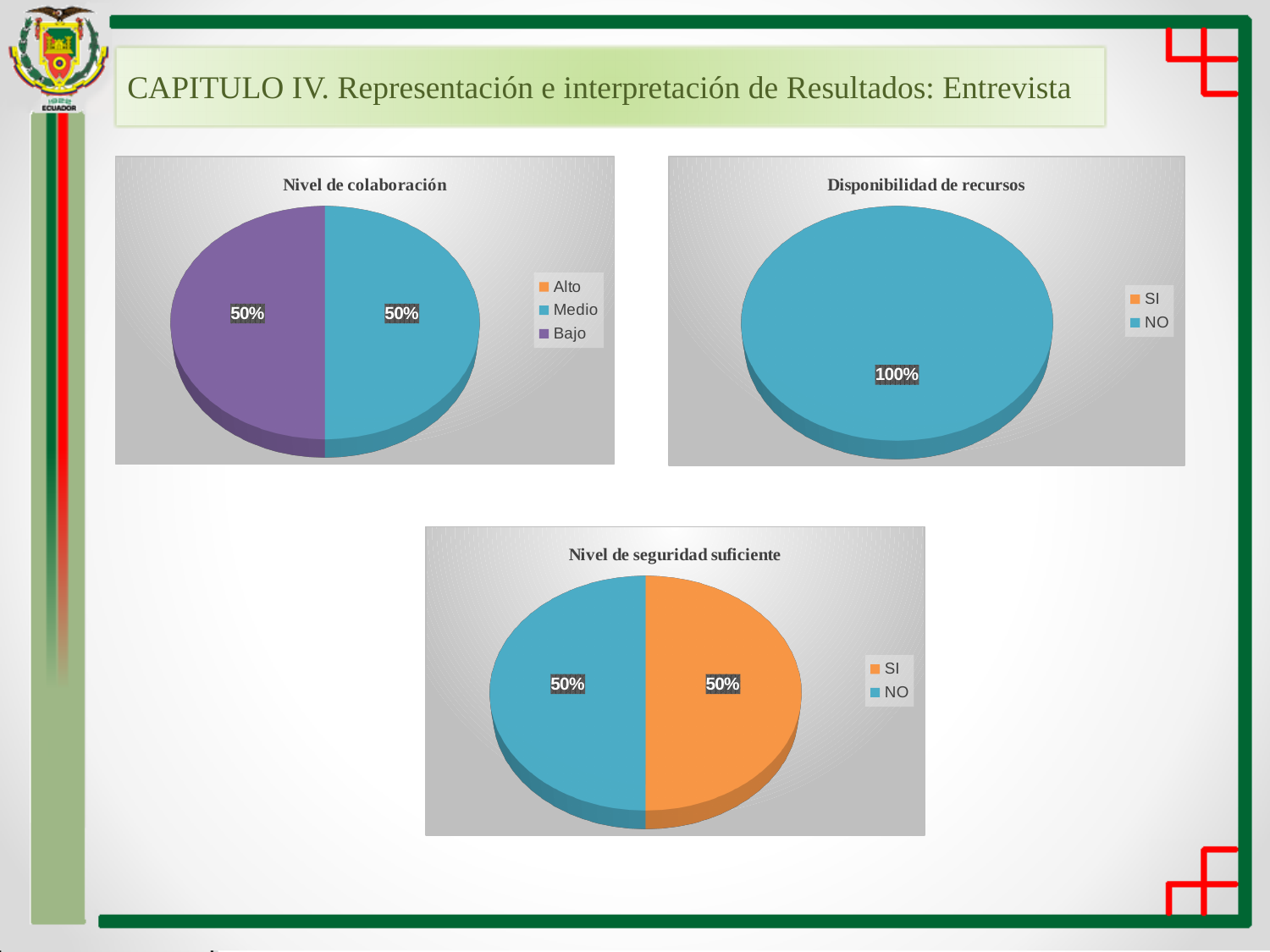
In the 'Nivel de seguridad suficiente' chart, what share of the pie does NO have? 50% In the 'Nivel de seguridad suficiente' chart, what colour is the SI slice? Orange How many charts are shown on the slide? 3 In the 'Disponibilidad de recursos' chart, how many entries does the legend list? 2 In the 'Nivel de colaboración' chart, what share of the pie does Medio have? 50% In the 'Nivel de colaboración' chart, how many entries does the legend list? 3 In the 'Nivel de seguridad suficiente' chart, what share of the pie does SI have? 50% What kind of chart is the 'Nivel de seguridad suficiente' chart? Pie chart In the 'Disponibilidad de recursos' chart, which category has the largest share? NO In the 'Nivel de colaboración' chart, which legend entry has no visible slice in the pie? Alto